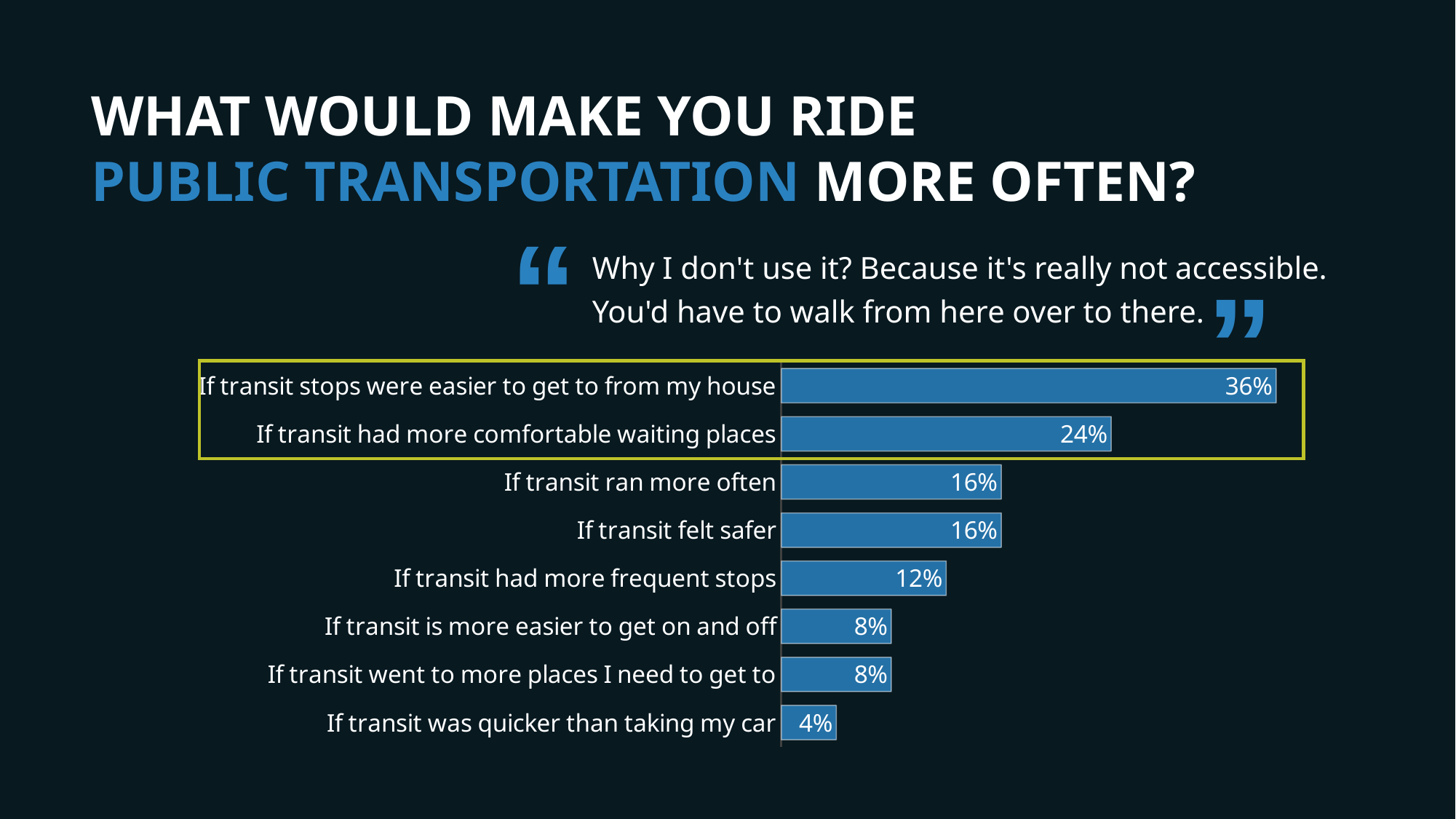
How many categories are shown in the chart? 8 Which category has the highest value in the chart? If transit stops were easier to get to from my house How many categories are enclosed by the yellow highlight box on the chart? 2 What is the difference between the values for "If transit stops were easier to get to from my house" and "If transit had more comfortable waiting places"? 12% What is the value for "If transit was quicker than taking my car"? 4% What kind of chart is shown on the slide? Bar chart Which category has the lowest value in the chart? If transit was quicker than taking my car What is the difference between the values for "If transit felt safer" and "If transit went to more places I need to get to"? 8% Which is larger: the value for "If transit ran more often" or the value for "If transit had more frequent stops"? If transit ran more often What is the value for "If transit had more comfortable waiting places"? 24% What percentage of respondents said they would ride public transportation more often if transit stops were easier to get to from their house? 36% What is the value for "If transit had more frequent stops"? 12%